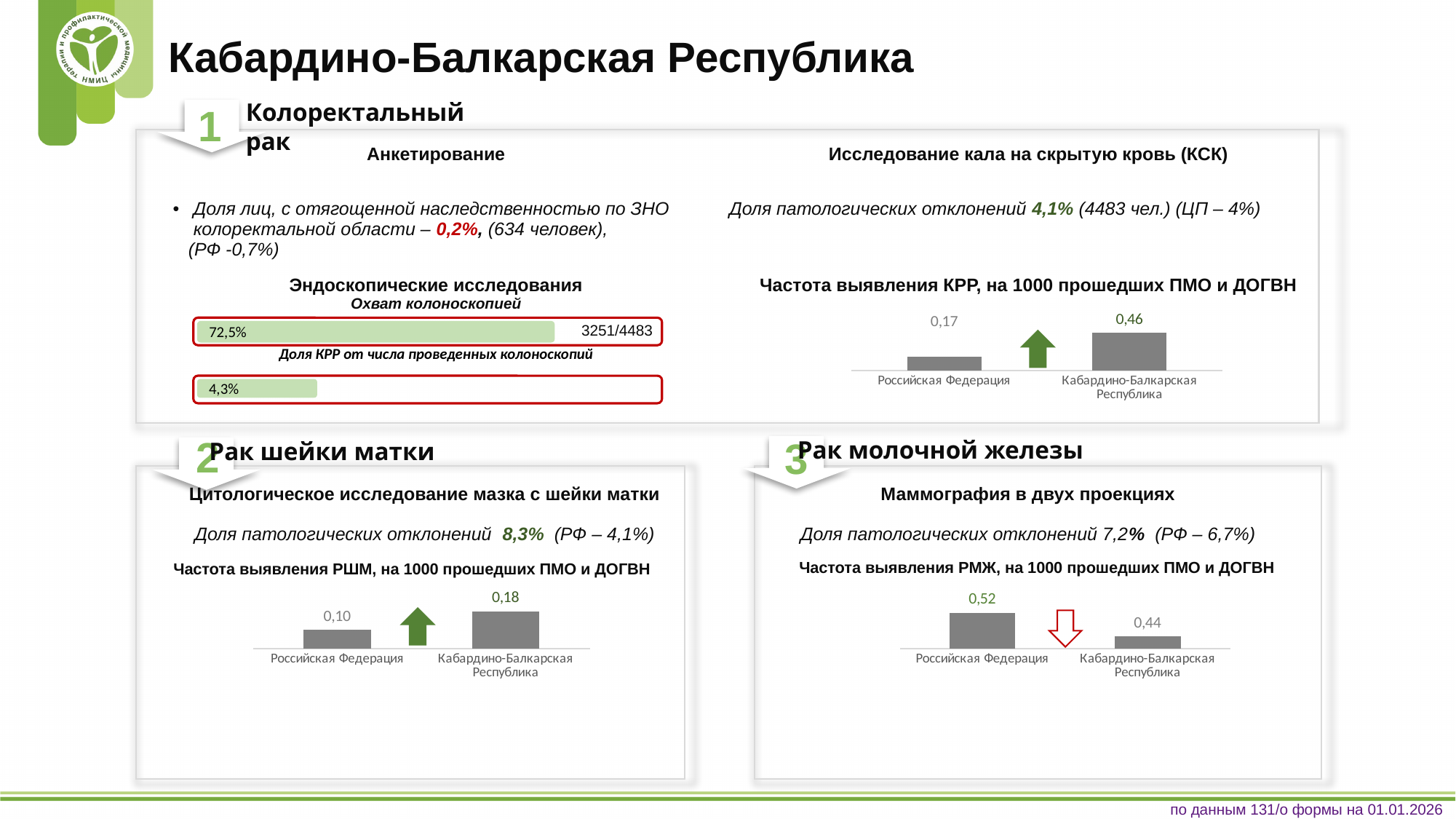
In the chart 'Частота выявления РМЖ, на 1000 прошедших ПМО и ДОГВН', which category has the lowest value? Кабардино-Балкарская Республика In the chart 'Частота выявления КРР, на 1000 прошедших ПМО и ДОГВН', what is the difference between Кабардино-Балкарская Республика and Российская Федерация? 0,29 What type of chart is 'Частота выявления КРР, на 1000 прошедших ПМО и ДОГВН'? bar chart In the chart 'Частота выявления РМЖ, на 1000 прошедших ПМО и ДОГВН', what is the value for Кабардино-Балкарская Республика? 0,44 In the chart 'Частота выявления РМЖ, на 1000 прошедших ПМО и ДОГВН', which is larger: Российская Федерация or Кабардино-Балкарская Республика? Российская Федерация In the chart 'Частота выявления КРР, на 1000 прошедших ПМО и ДОГВН', what is the value for Кабардино-Балкарская Республика? 0,46 In the chart 'Частота выявления РШМ, на 1000 прошедших ПМО и ДОГВН', which category has the highest value? Кабардино-Балкарская Республика How many categories are shown in the chart 'Частота выявления РМЖ, на 1000 прошедших ПМО и ДОГВН'? 2 In the 'Эндоскопические исследования' section, what is the value shown for 'Охват колоноскопией'? 72,5% In the chart 'Частота выявления РШМ, на 1000 прошедших ПМО и ДОГВН', what is the value for Российская Федерация? 0,10 In the chart 'Частота выявления РШМ, на 1000 прошедших ПМО и ДОГВН', what is the difference between Кабардино-Балкарская Республика and Российская Федерация? 0,08 In the chart 'Частота выявления КРР, на 1000 прошедших ПМО и ДОГВН', what is the value for Российская Федерация? 0,17